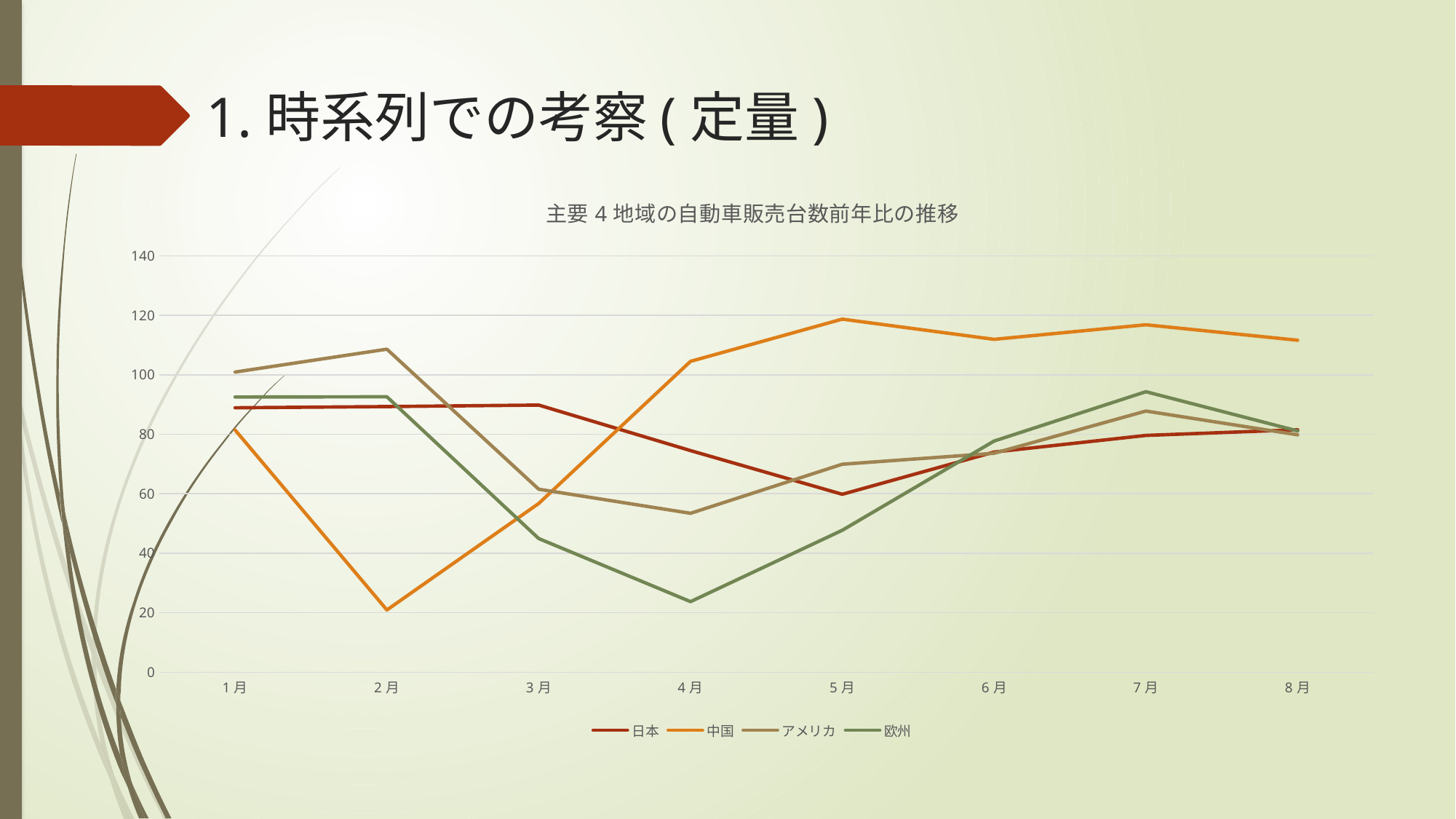
Is the value for 欧州 in 4月 greater or less than 40? less Is the value for アメリカ in 2月 greater or less than 100? greater How many months are shown on the x axis? 8 In 4月, which is larger, the value for 日本 or the value for 欧州? 日本 What is the title of the chart? 主要4地域の自動車販売台数前年比の推移 How many series does the legend list? 4 What kind of chart is shown on the slide? line chart Is the value for 中国 in 5月 greater or less than 100? greater Which series has the highest value in 5月? 中国 In which month is the value for 中国 lowest? 2月 Which series has the lowest value in 4月? 欧州